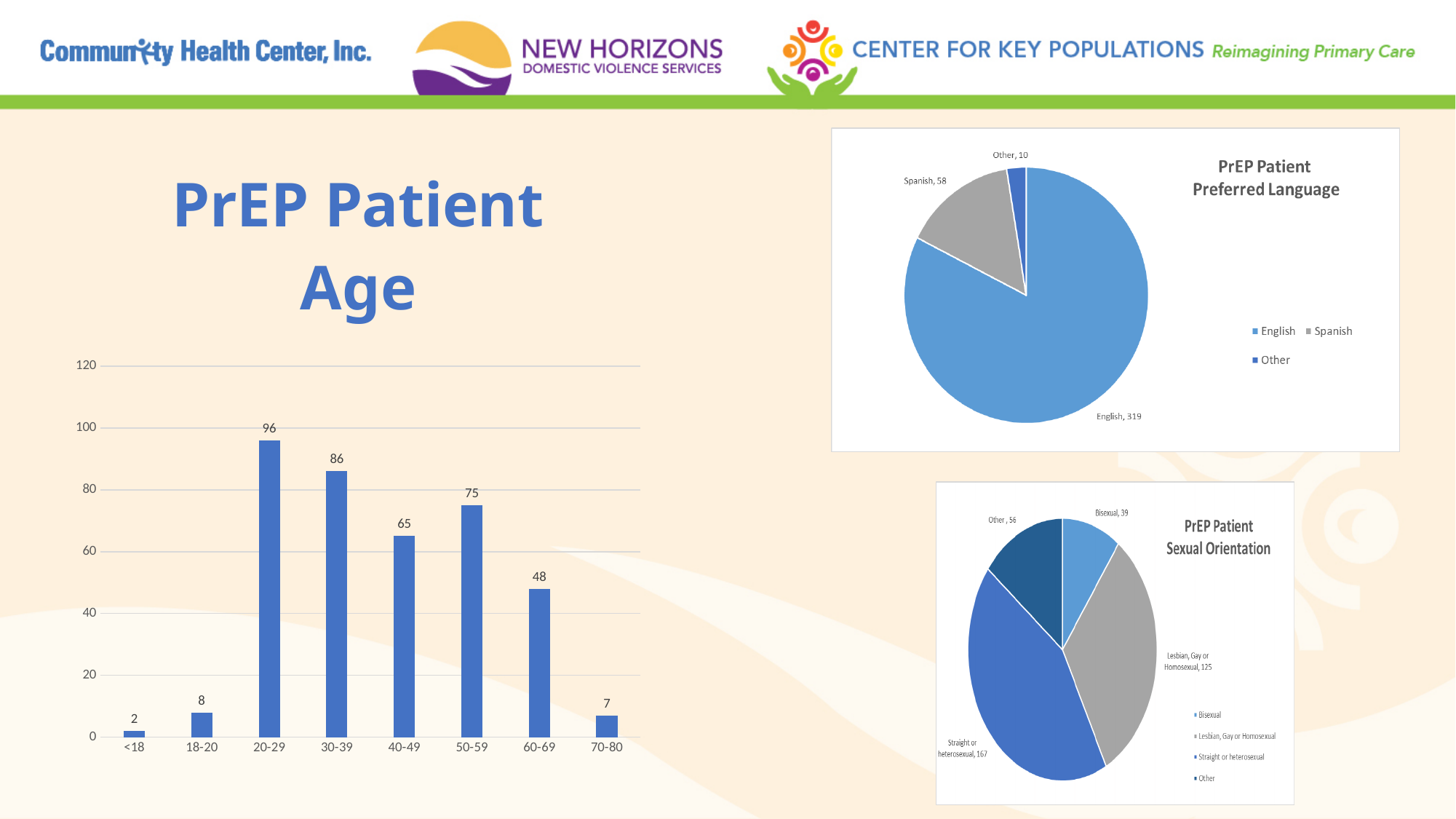
In the PrEP Patient Age chart, which is larger: the value for 50-59 or the value for 60-69? 50-59 In the PrEP Patient Age chart, which age group has the lowest number of patients? <18 In the PrEP Patient Preferred Language chart, how many patients prefer Spanish? 58 In the PrEP Patient Age chart, how many patients are in the 20-29 age group? 96 What type of chart is the PrEP Patient Age chart? Bar chart In the PrEP Patient Preferred Language chart, which language has the smallest slice? Other In the PrEP Patient Age chart, which age group has the highest number of patients? 20-29 How many age groups are shown in the PrEP Patient Age chart? 8 In the PrEP Patient Age chart, what is the difference between the 30-39 and 40-49 age groups? 21 In the PrEP Patient Sexual Orientation chart, how many patients are Lesbian, Gay or Homosexual? 125 How many categories does the legend of the PrEP Patient Sexual Orientation chart list? 4 In the PrEP Patient Sexual Orientation chart, what is the difference between the Straight or heterosexual and Bisexual values? 128